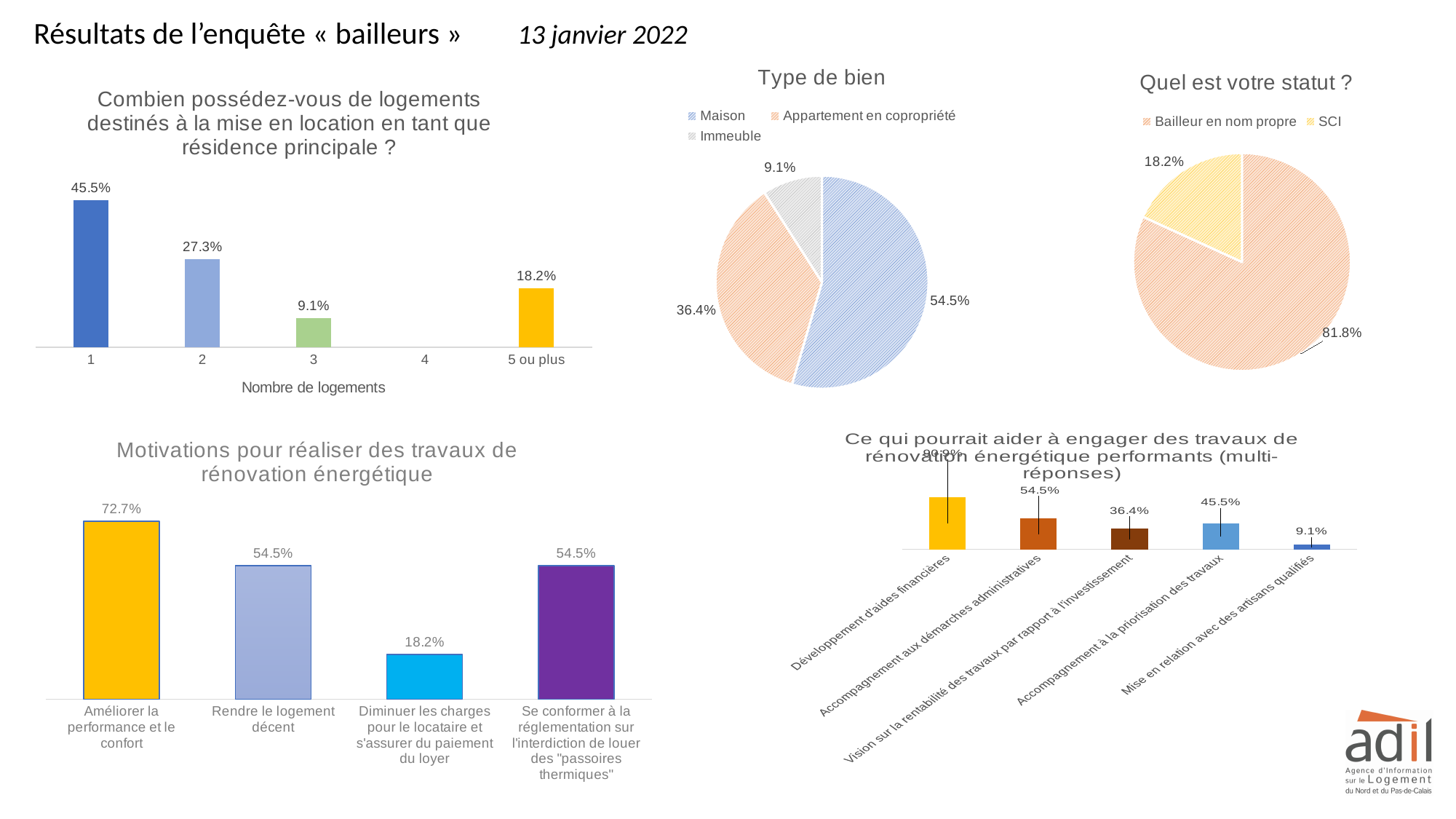
How many series does the legend of the pie chart 'Type de bien' list? 3 In the chart 'Motivations pour réaliser des travaux de rénovation énergétique', which category has the highest value? Améliorer la performance et le confort In the chart 'Motivations pour réaliser des travaux de rénovation énergétique', what is the value for 'Diminuer les charges pour le locataire et s'assurer du paiement du loyer'? 18.2% In the pie chart 'Type de bien', what share does 'Maison' have? 54.5% In the pie chart 'Type de bien', which category has the smallest share? Immeuble What kind of chart is 'Motivations pour réaliser des travaux de rénovation énergétique'? Bar chart In the chart 'Ce qui pourrait aider à engager des travaux de rénovation énergétique performants (multi-réponses)', what is the value for 'Accompagnement aux démarches administratives'? 54.5% In the chart 'Combien possédez-vous de logements destinés à la mise en location en tant que résidence principale ?', what is the value for '5 ou plus'? 18.2% In the pie chart 'Quel est votre statut ?', what share does 'SCI' have? 18.2% In the chart 'Ce qui pourrait aider à engager des travaux de rénovation énergétique performants (multi-réponses)', which is larger: 'Vision sur la rentabilité des travaux par rapport à l'investissement' or 'Accompagnement à la priorisation des travaux'? Accompagnement à la priorisation des travaux In the chart 'Combien possédez-vous de logements destinés à la mise en location en tant que résidence principale ?', what is the difference between the values for '1' and '2'? 18.2% In the chart 'Combien possédez-vous de logements destinés à la mise en location en tant que résidence principale ?', what is the value for '1' logement? 45.5%